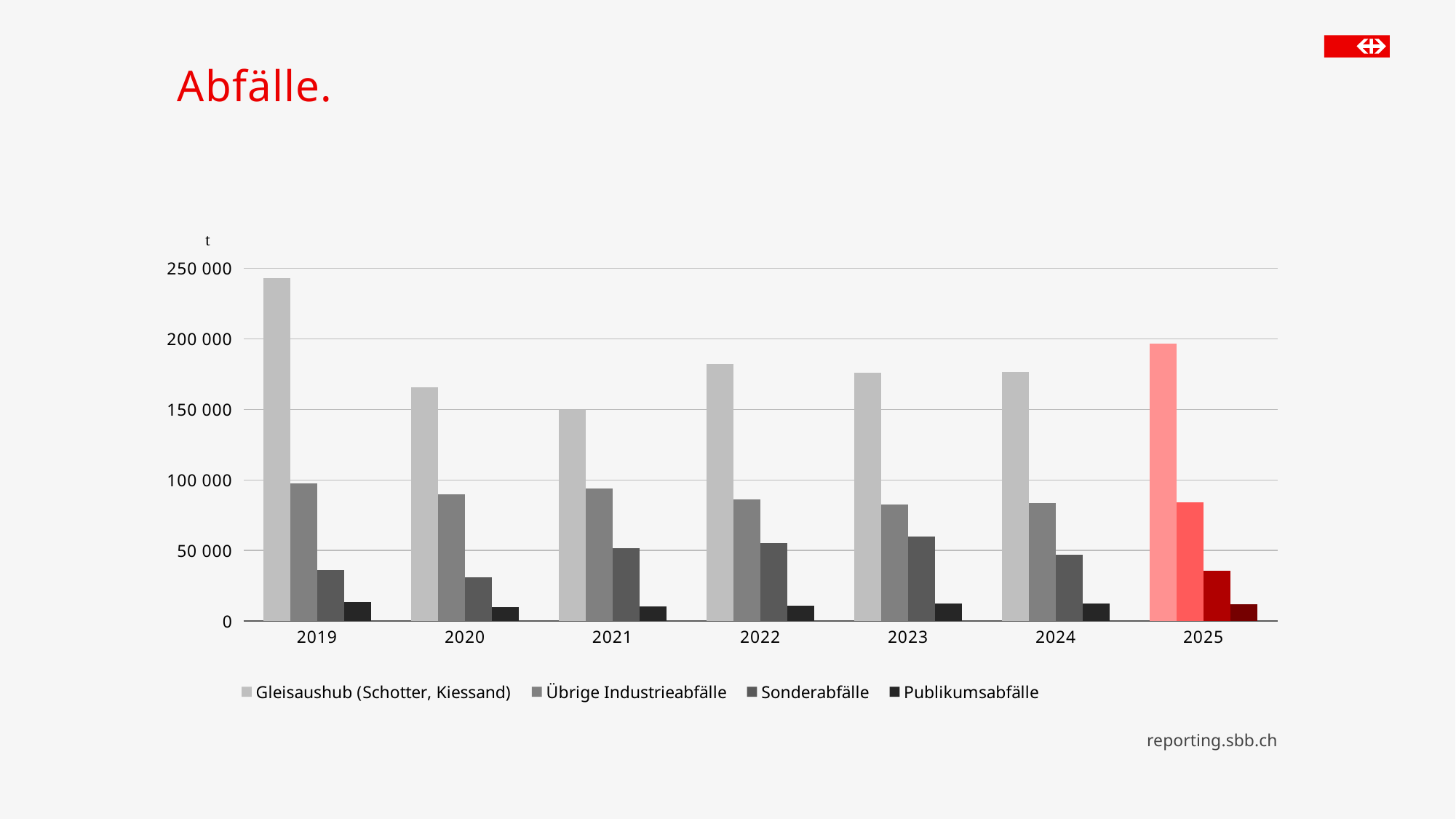
In which year is the Gleisaushub (Schotter, Kiessand) value lowest? 2021 How many years are shown on the x axis? 7 Is the Sonderabfälle value for 2023 greater or less than 50 000? greater Is the Gleisaushub (Schotter, Kiessand) value for 2020 greater or less than 150 000? greater Which year has the larger Sonderabfälle value, 2020 or 2021? 2021 In which year is the Sonderabfälle value highest? 2023 Which year's bars are highlighted in red? 2025 Is the Gleisaushub (Schotter, Kiessand) value for 2019 greater or less than 200 000? greater What kind of chart is shown on the slide? bar chart In which year is the Gleisaushub (Schotter, Kiessand) value highest? 2019 How many series does the legend list? 4